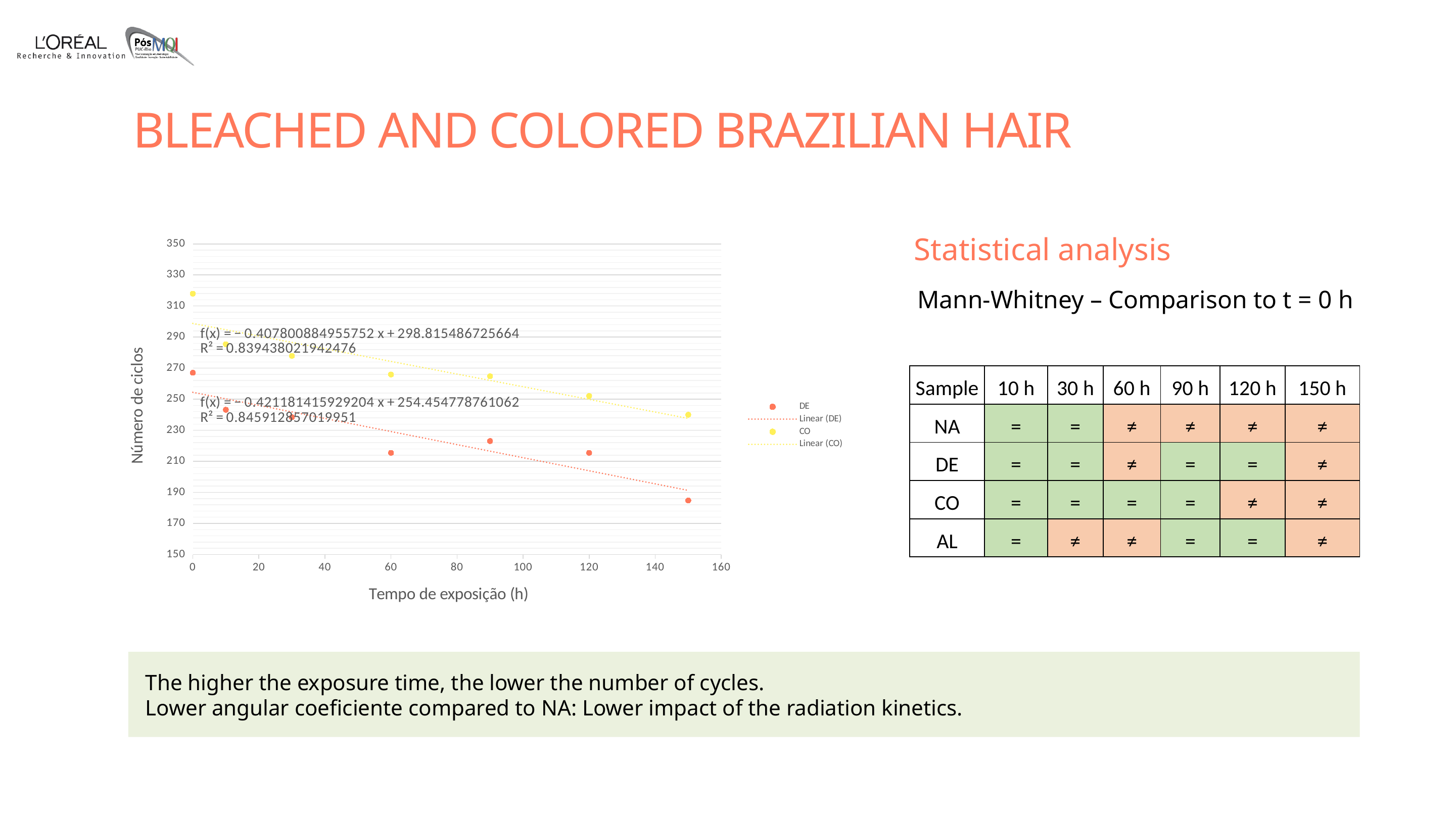
What is the title of the chart's y axis? Número de ciclos At which exposure time is the DE series lowest? 150 h How many entries does the chart legend list? 4 Is the CO value at 0 h greater or less than 310? greater What kind of chart is shown on the slide? scatter chart Is the DE value at 150 h greater or less than 190? less Do the DE values rise or fall as exposure time increases along the x axis? fall How many data points are plotted for the DE series? 7 At 150 h, which series has the larger number of cycles, DE or CO? CO Is the DE value at 60 h greater or less than 230? less At which exposure time is the CO series highest? 0 h Do the CO values rise or fall as exposure time increases? fall